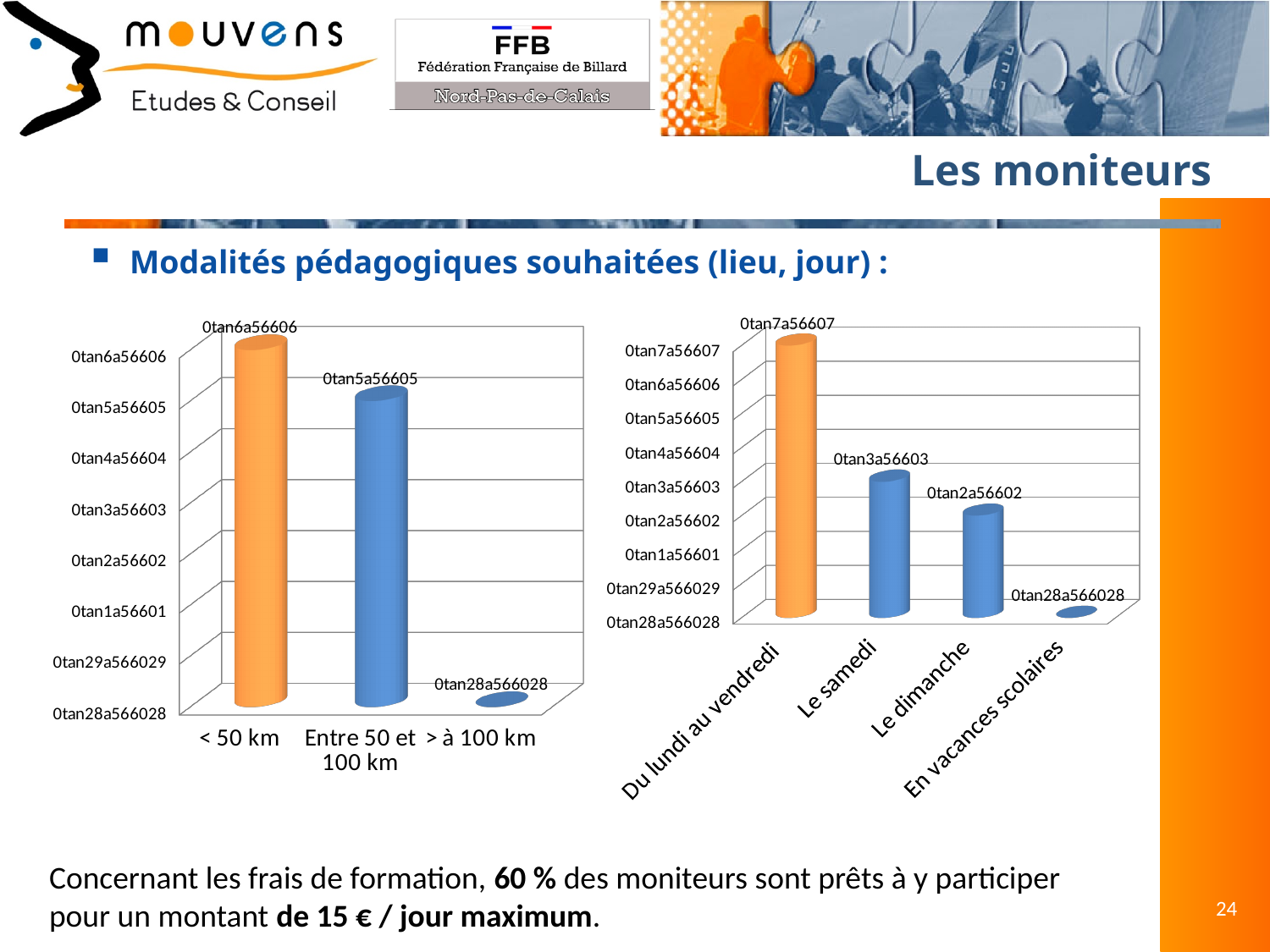
In the right chart, do the values rise or fall from left to right along the x axis? fall In the right chart, which category has the lowest value? En vacances scolaires In the right chart, which category has the highest value? Du lundi au vendredi In the left chart, which is larger: < 50 km or Entre 50 et 100 km? < 50 km What kind of chart is the left chart on the slide? bar chart In the left chart, which category has the lowest value? > à 100 km How many categories does the left chart show? 3 In the right chart, which is larger: Le samedi or Le dimanche? Le samedi How many categories does the right chart show? 4 In the left chart, which category is shown with an orange bar? < 50 km In the left chart, which category has the highest value? < 50 km What kind of chart is the right chart on the slide? bar chart